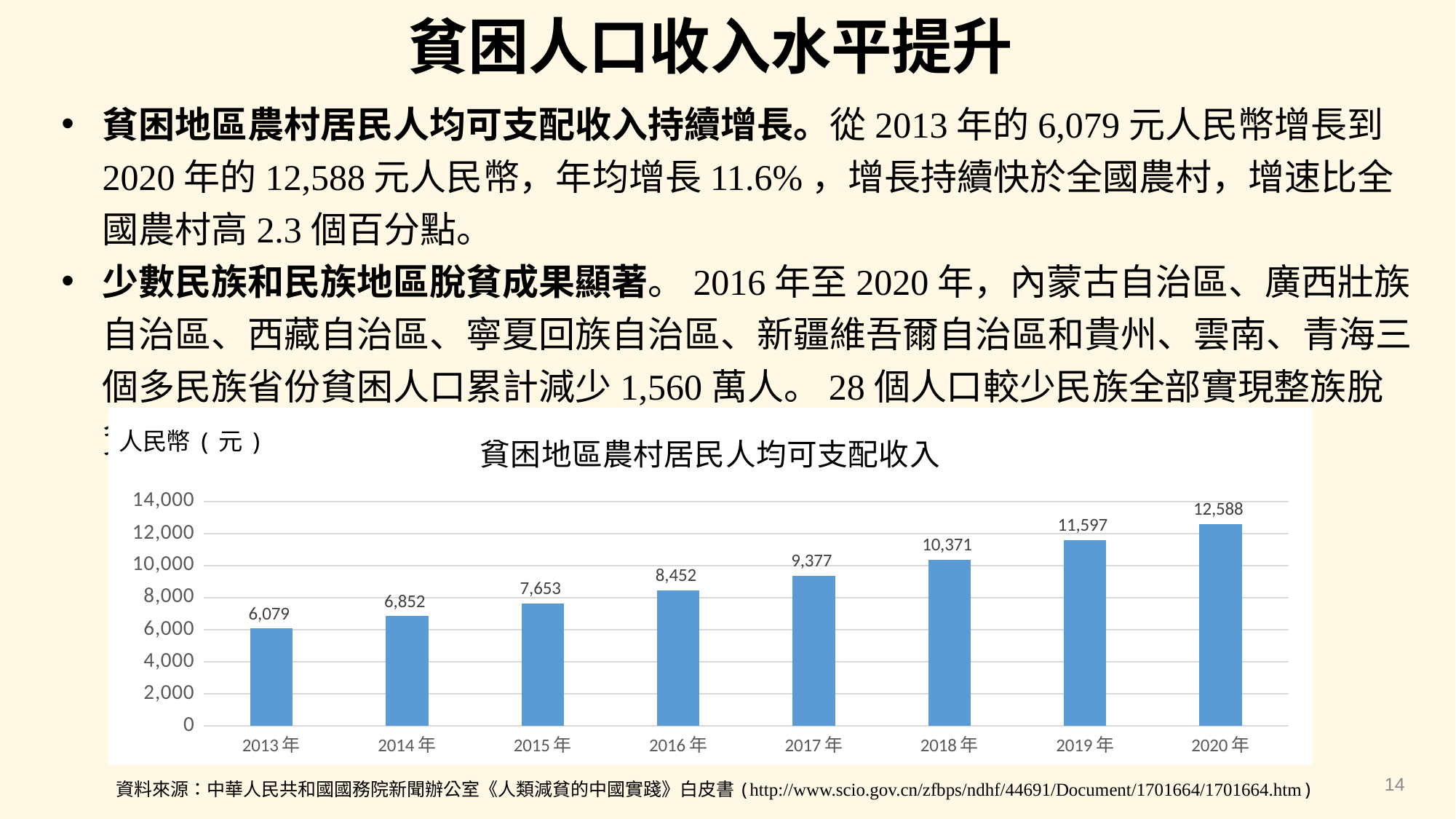
What is the value for 2013年 in the chart? 6,079 What is the value for 2017年 in the chart? 9,377 What is the difference between the values for 2016年 and 2015年? 799 Which is larger, the value for 2018年 or the value for 2016年? 2018年 What is the value for 2019年 in the chart? 11,597 Is the value for 2018年 greater or less than 10,000? greater Which year has the highest value in the chart? 2020年 Do the values rise or fall from 2013年 to 2020年? rise How many years are shown on the x axis of the chart? 8 Which year has the lowest value in the chart? 2013年 What kind of chart is shown on the slide? bar chart What is the difference between the values for 2020年 and 2013年? 6,509